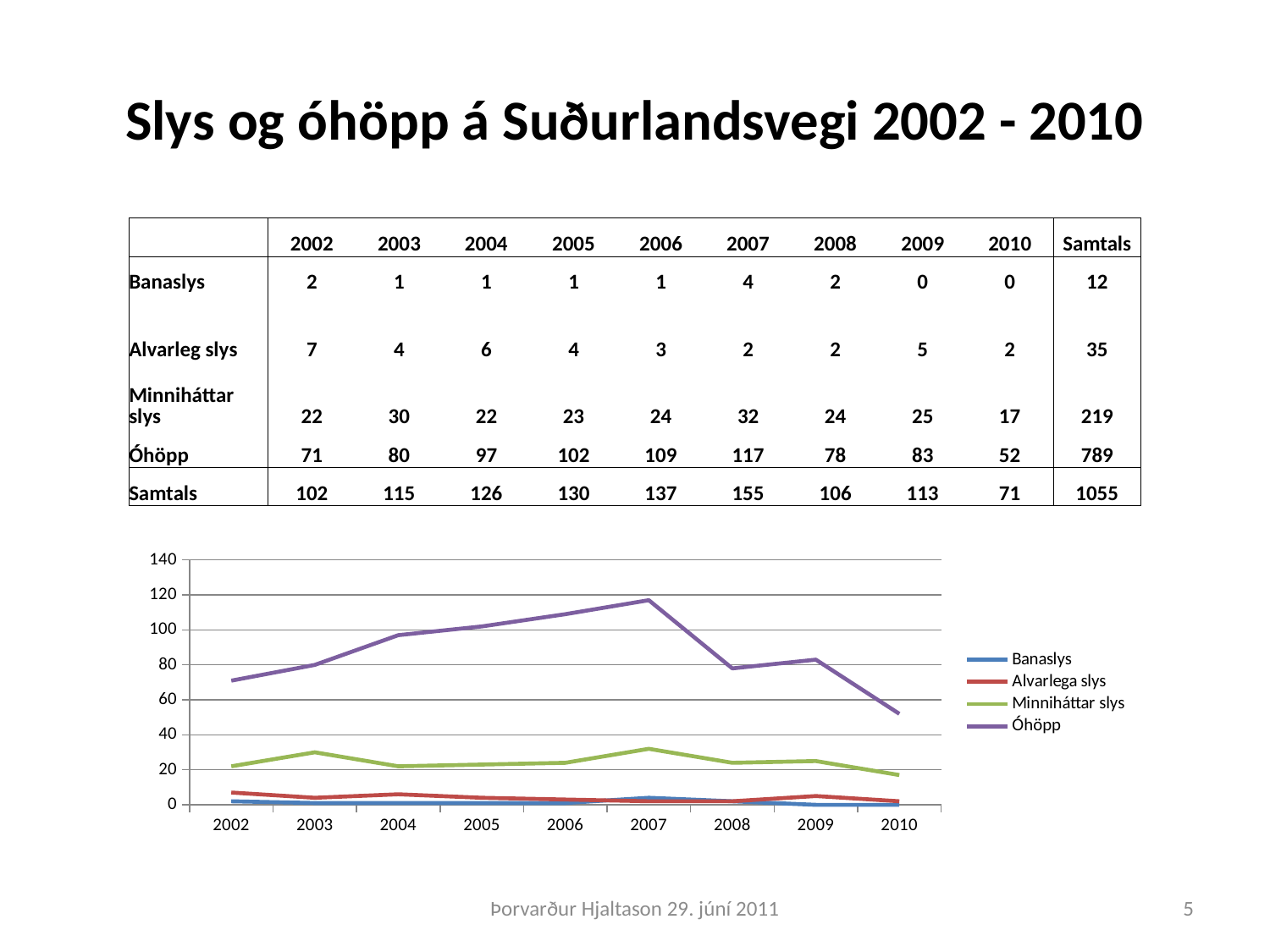
In which year does the Óhöpp line reach its highest value? 2007 How many years are plotted along the x axis of the chart? 9 Does the Óhöpp line rise or fall from 2002 to 2007? rise What colour is the Óhöpp line in the chart? purple In which year does the Óhöpp line reach its lowest value? 2010 Which is larger: Minniháttar slys in 2007 or in 2010? 2007 Is the value for Óhöpp in 2004 greater or less than 80? greater What is the value of Minniháttar slys in 2010? 17 By how much did Óhöpp fall from 2007 to 2008? 39 What is the value of Óhöpp in 2006? 109 How many series does the chart legend list? 4 What kind of chart is shown on the slide? line chart